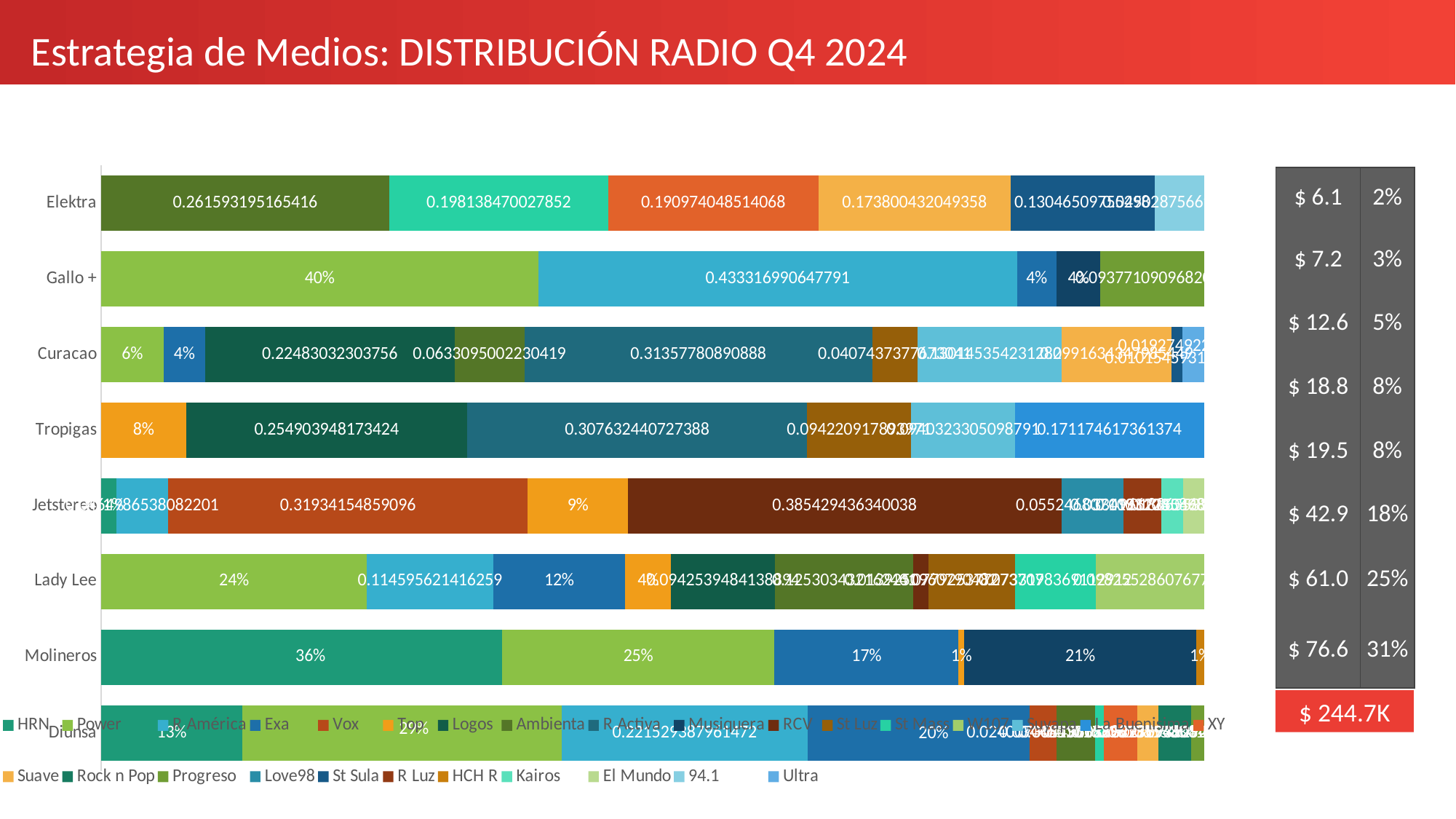
Which segment of the Molineros bar is the largest? The first segment, 36% What is the value of the second segment of the Diunsa bar? 29% What is the title of the slide containing the chart? Estrategia de Medios: DISTRIBUCIÓN RADIO Q4 2024 What is the difference between the first segment (36%) and the second segment (25%) of the Molineros bar? 11% What is the value of the first (leftmost) segment of the Tropigas bar? 8% What kind of chart is shown on the slide? Stacked bar chart How many categories (retailers) are plotted on the y axis of the chart? 8 What is the value of the first (leftmost) segment of the Gallo + bar? 40% What is the value of the first (leftmost) segment of the Elektra bar? 0.261593195165416 What is the value of the first (leftmost) segment of the Molineros bar? 36% Which is larger: the first segment of the Molineros bar or the first segment of the Gallo + bar? Gallo + What is the value of the first (leftmost) segment of the Lady Lee bar? 24%